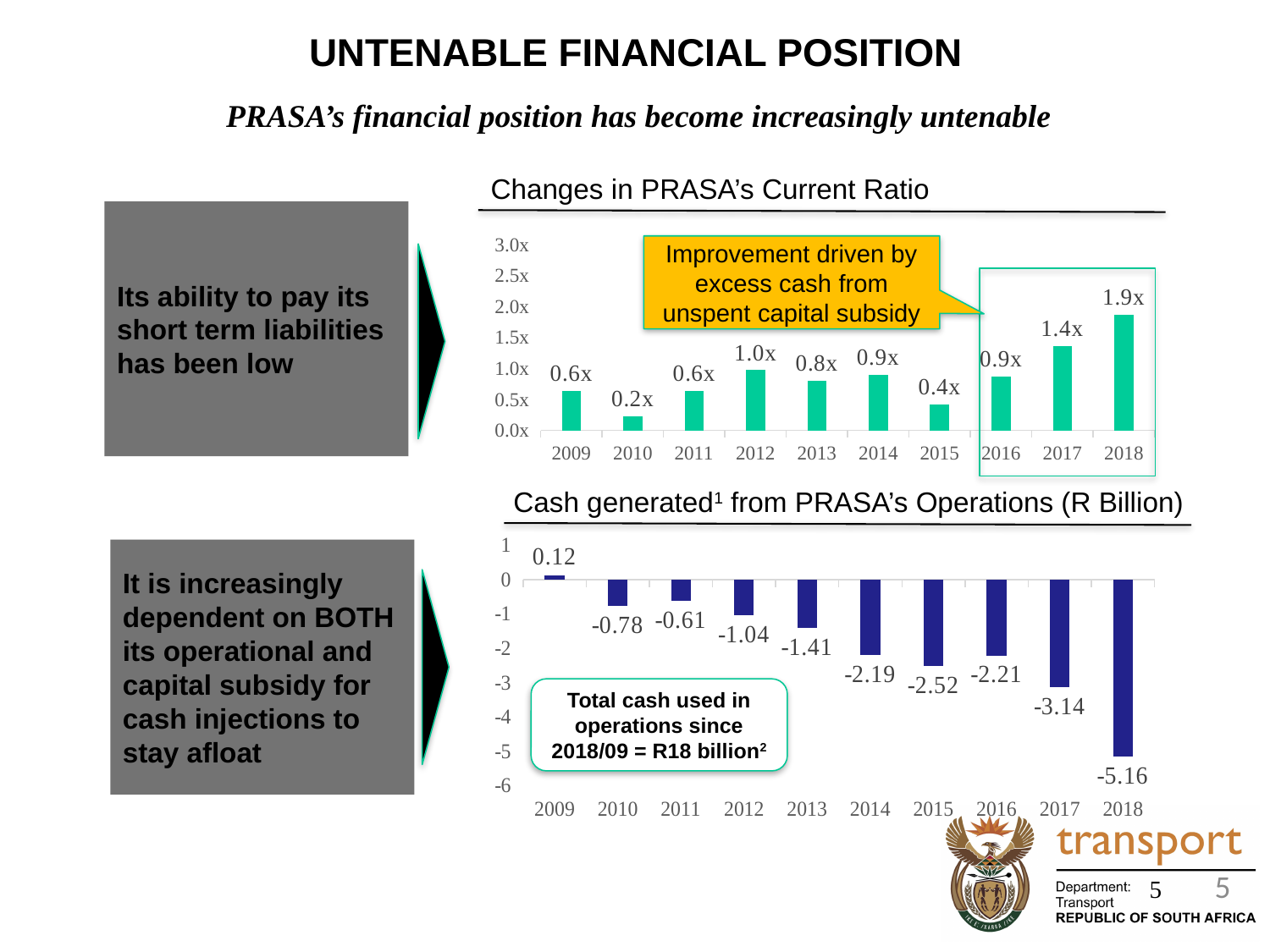
In the 'Cash generated from PRASA's Operations (R Billion)' chart, what is the value for 2018? -5.16 What type of chart is 'Cash generated from PRASA's Operations (R Billion)'? Bar chart In the 'Changes in PRASA's Current Ratio' chart, what is the value for 2015? 0.4x In the 'Changes in PRASA's Current Ratio' chart, which year has the highest current ratio? 2018 In the 'Cash generated from PRASA's Operations (R Billion)' chart, what is the difference between the 2017 and 2018 values? 2.02 In the 'Changes in PRASA's Current Ratio' chart, is the value for 2017 greater or less than 1.0x? greater In the 'Changes in PRASA's Current Ratio' chart, which year has the lowest current ratio? 2010 In the 'Cash generated from PRASA's Operations (R Billion)' chart, what is the value for 2015? -2.52 In the 'Cash generated from PRASA's Operations (R Billion)' chart, which year has the lowest value? 2018 In the 'Changes in PRASA's Current Ratio' chart, how many years are shown on the x axis? 10 In the 'Changes in PRASA's Current Ratio' chart, what is the value for 2018? 1.9x In the 'Cash generated from PRASA's Operations (R Billion)' chart, which year is the only one with a positive value? 2009